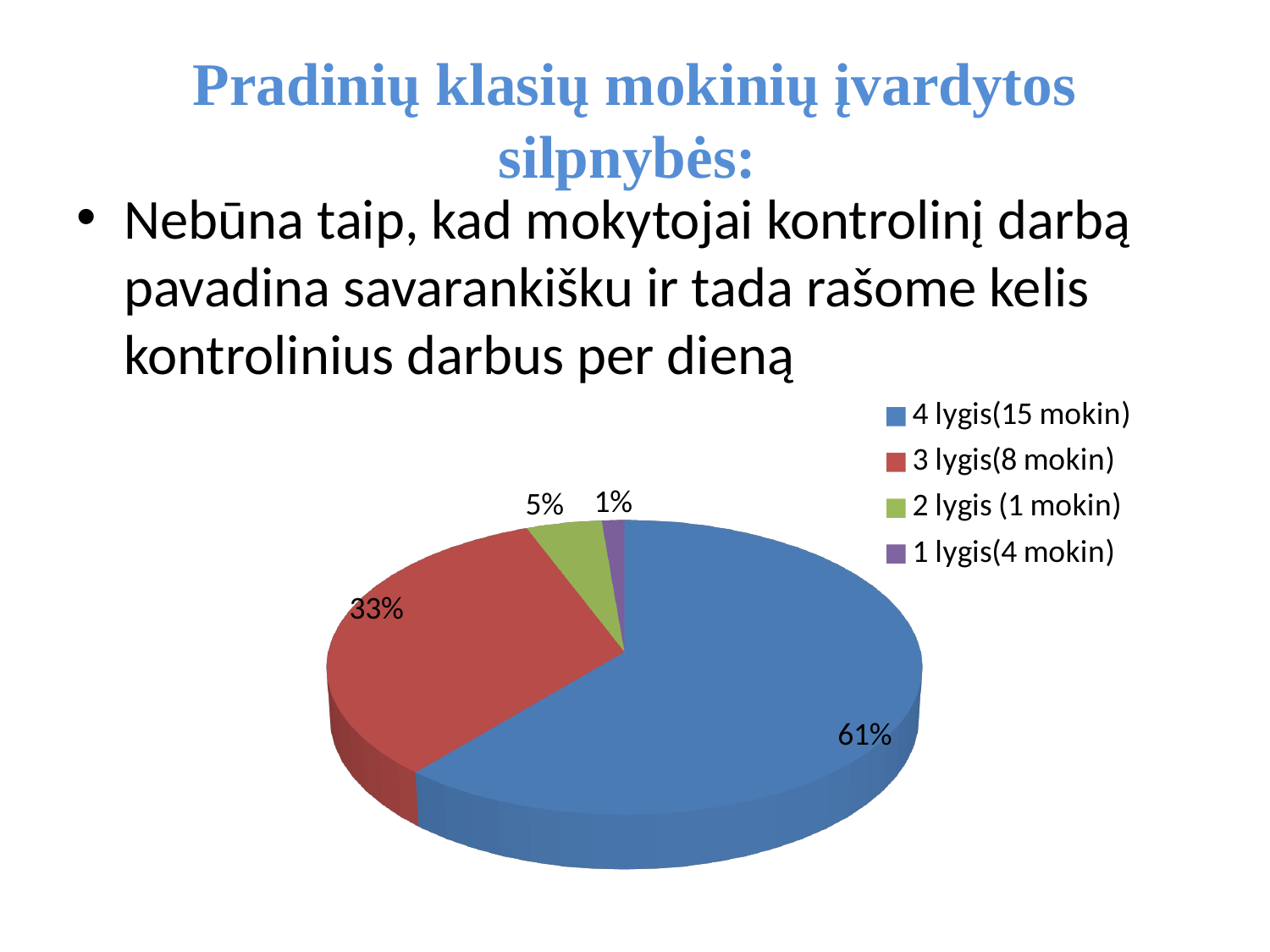
Which slice of the pie is the smallest? 1 lygis(4 mokin) What percentage of the pie is labelled for the "1 lygis(4 mokin)" slice? 1% What percentage of the pie is labelled for the "3 lygis(8 mokin)" slice? 33% What is the difference in percentage points between the "4 lygis(15 mokin)" slice and the "3 lygis(8 mokin)" slice? 28 How many entries does the legend of the pie chart list? 4 What colour is the "3 lygis(8 mokin)" slice in the pie chart? red What percentage of the pie is labelled for the "4 lygis(15 mokin)" slice? 61% What percentage of the pie is labelled for the "2 lygis (1 mokin)" slice? 5% How many slices does the pie chart have? 4 What kind of chart is shown on the slide? pie chart Which slice is larger, "2 lygis (1 mokin)" or "1 lygis(4 mokin)"? 2 lygis (1 mokin) Which slice of the pie is the largest? 4 lygis(15 mokin)